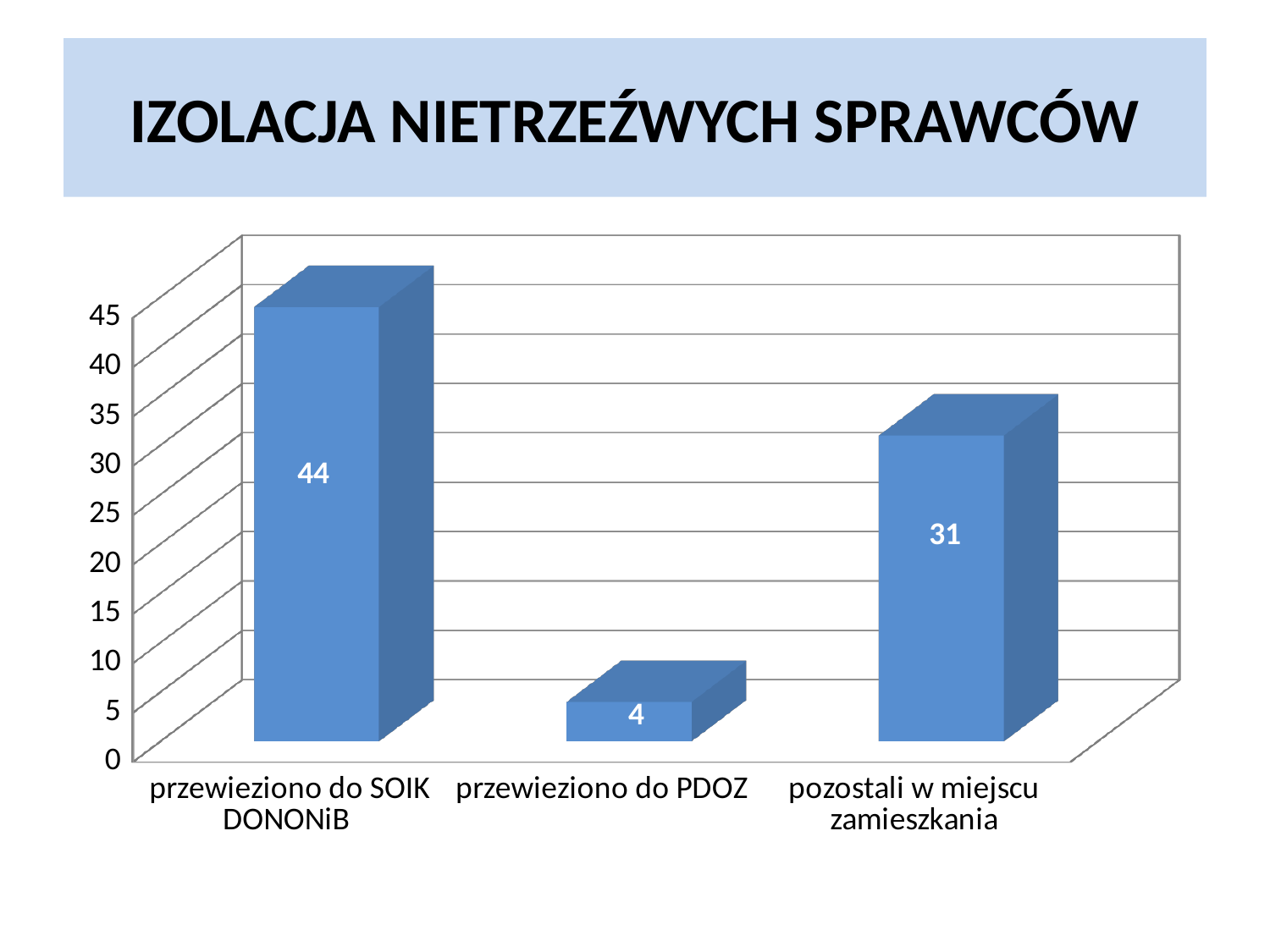
How many categories are shown on the chart? 3 What is the difference between the values for "przewieziono do SOIK DONONiB" and "pozostali w miejscu zamieszkania"? 13 Which is larger: the value for "pozostali w miejscu zamieszkania" or the value for "przewieziono do PDOZ"? pozostali w miejscu zamieszkania Which category has the lowest value? przewieziono do PDOZ What is the value for "pozostali w miejscu zamieszkania"? 31 What is the difference between the values for "pozostali w miejscu zamieszkania" and "przewieziono do PDOZ"? 27 What kind of chart is shown on the slide? bar chart Is the value for "pozostali w miejscu zamieszkania" greater or less than 20? greater What is the title of the slide? IZOLACJA NIETRZEŹWYCH SPRAWCÓW What is the value for "przewieziono do SOIK DONONiB"? 44 What is the value for "przewieziono do PDOZ"? 4 Which category has the highest value? przewieziono do SOIK DONONiB